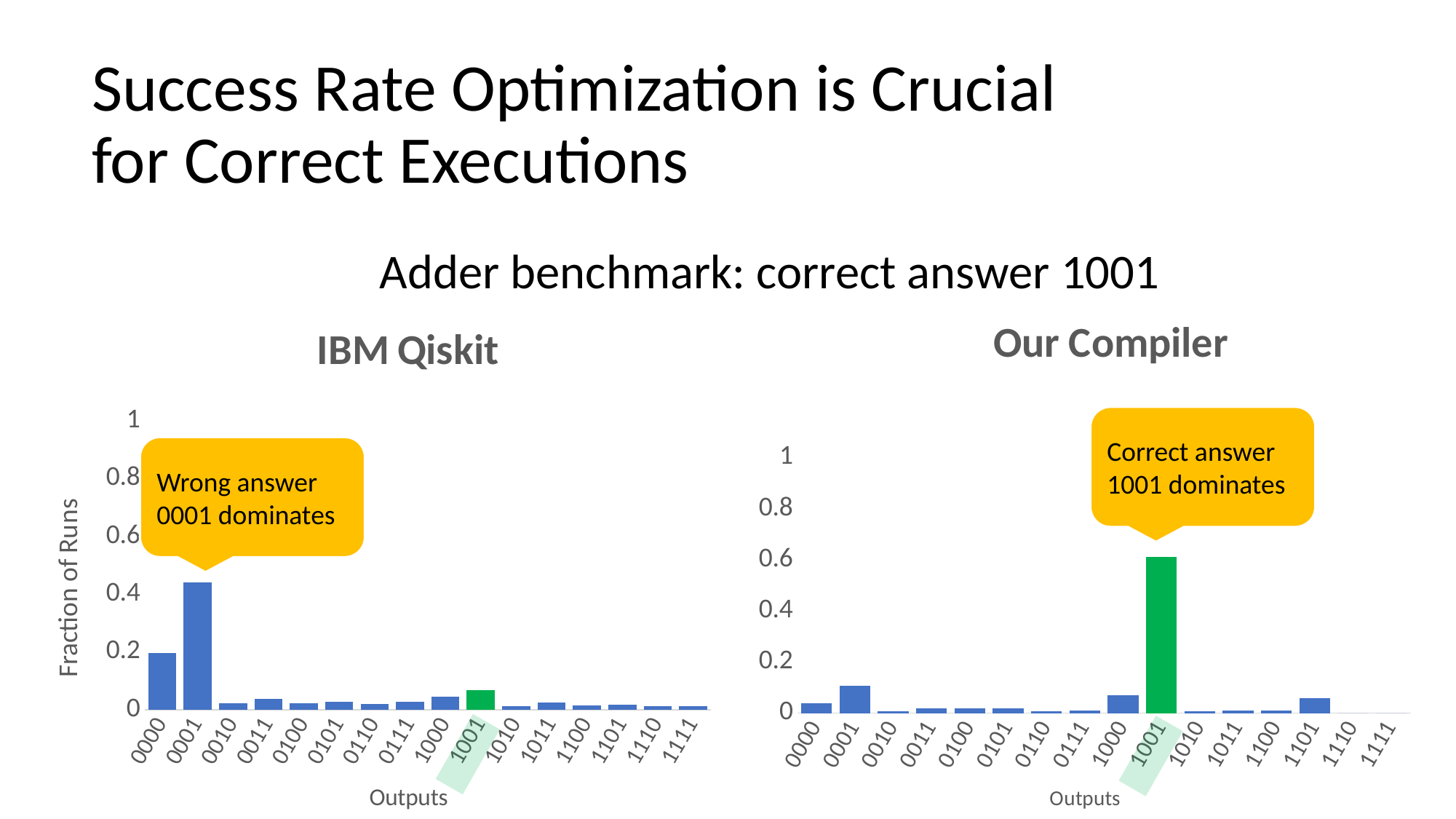
In the Our Compiler chart, which output has the highest fraction of runs? 1001 What is the y-axis title of the IBM Qiskit chart? Fraction of Runs What kind of chart is the IBM Qiskit chart? bar chart In the IBM Qiskit chart, is the value for output 1001 greater or less than 0.2? less In the IBM Qiskit chart, which output has the highest fraction of runs? 0001 How many output categories are shown on the x axis of the Our Compiler chart? 16 In the Our Compiler chart, which output has the larger value, 1001 or 0000? 1001 In the Our Compiler chart, is the value for output 0001 greater or less than 0.2? less In the IBM Qiskit chart, which output has the larger value, 0001 or 1001? 0001 In the Our Compiler chart, which output's bar is coloured green? 1001 In the IBM Qiskit chart, is the value for output 0001 greater or less than 0.2? greater